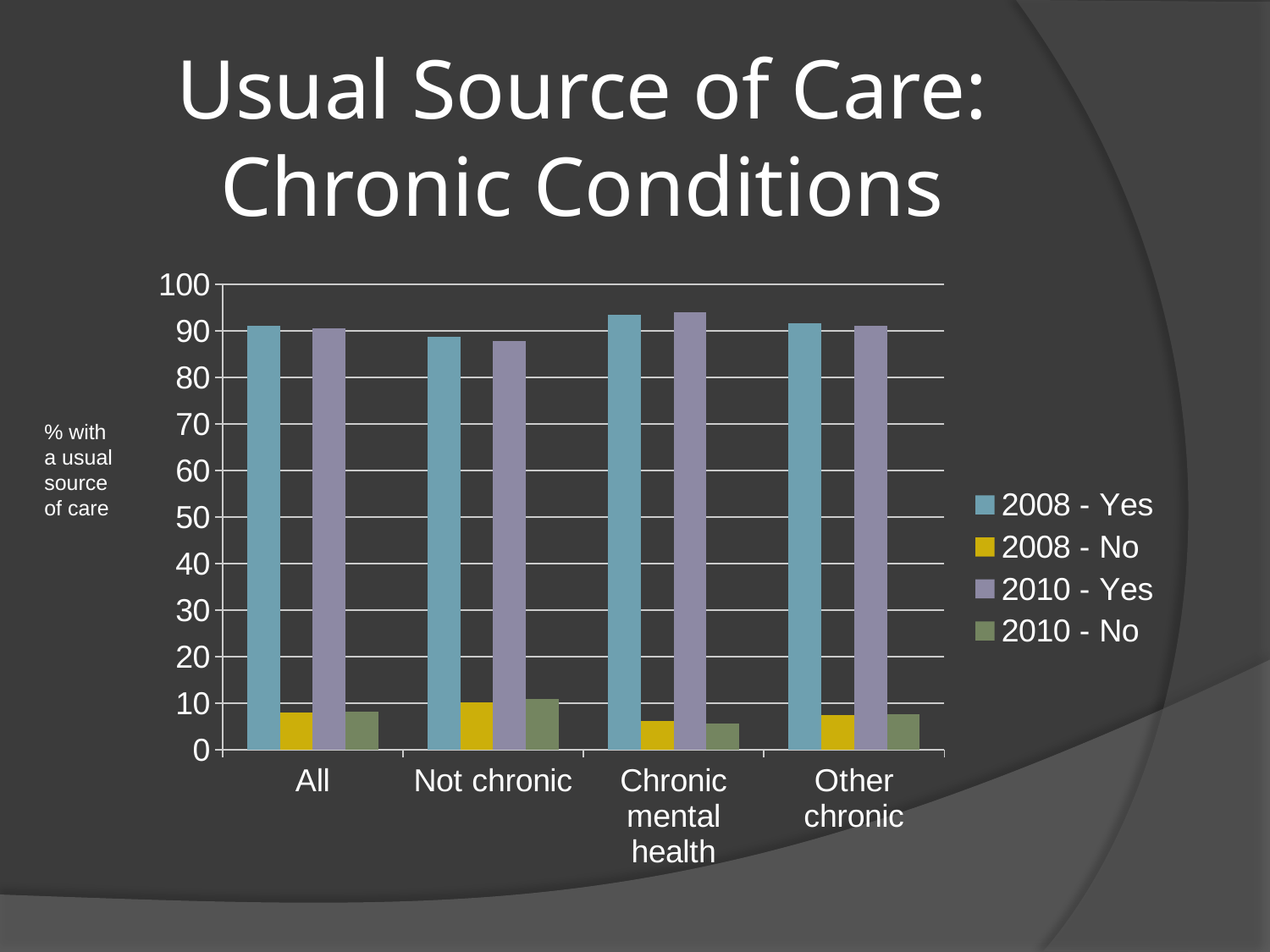
How many series does the legend list? 4 Is the 2008 - No value for Chronic mental health greater or less than 10? less Which is larger for Chronic mental health: the 2010 - Yes value or the 2010 - No value? 2010 - Yes What kind of chart is shown on the slide? bar chart How many categories are shown on the x axis? 4 Is the 2010 - Yes value for Not chronic greater or less than 90? less Is the 2008 - Yes value for All greater or less than 80? greater Which category has the highest value for the 2010 - No series? Not chronic Which category has the lowest value for the 2010 - Yes series? Not chronic Which category has the highest value for the 2008 - No series? Not chronic Which category has the highest value for the 2010 - Yes series? Chronic mental health What is the title of the chart on the slide? Usual Source of Care: Chronic Conditions